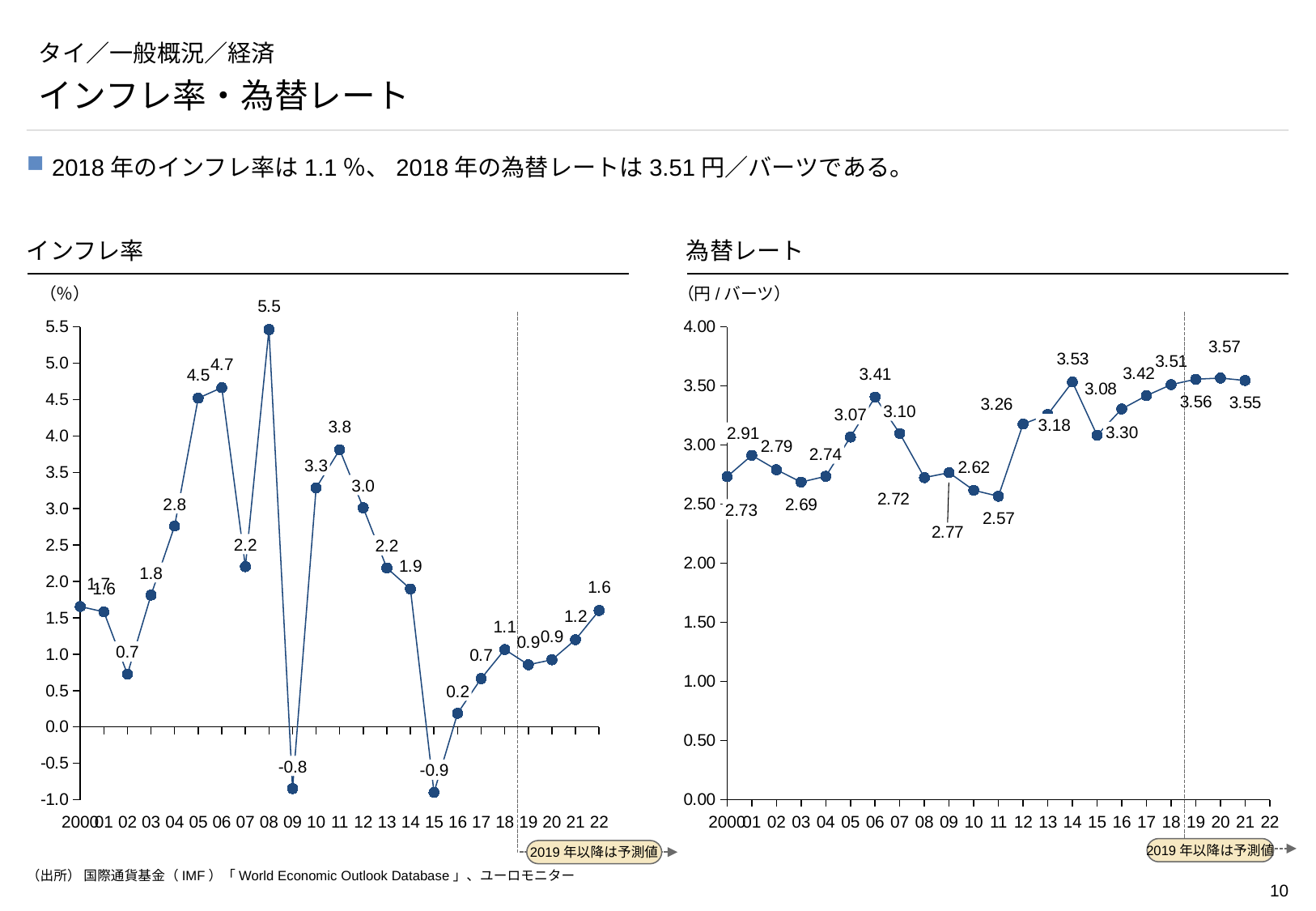
In the 為替レート chart, what is the exchange rate for 2018? 3.51 In the インフレ率 chart, how many data points are plotted? 23 In the インフレ率 chart, what is the difference between the 2008 value and the 2009 value? 6.3 In the インフレ率 chart, what is the inflation rate for 2018? 1.1 In the インフレ率 chart, which year has the highest inflation rate? 2008 In the 為替レート chart, what unit is shown for the values? 円/バーツ What kind of chart is the インフレ率 chart? Line chart In the 為替レート chart, what is the difference between the 2018 value and the 2000 value? 0.78 In the 為替レート chart, which year has the lowest value? 2011 In the インフレ率 chart, which year has the lowest inflation rate? 2015 In the 為替レート chart, which year has the highest value? 2020 In the 為替レート chart, which is larger, the value for 2006 or the value for 2014? 2014